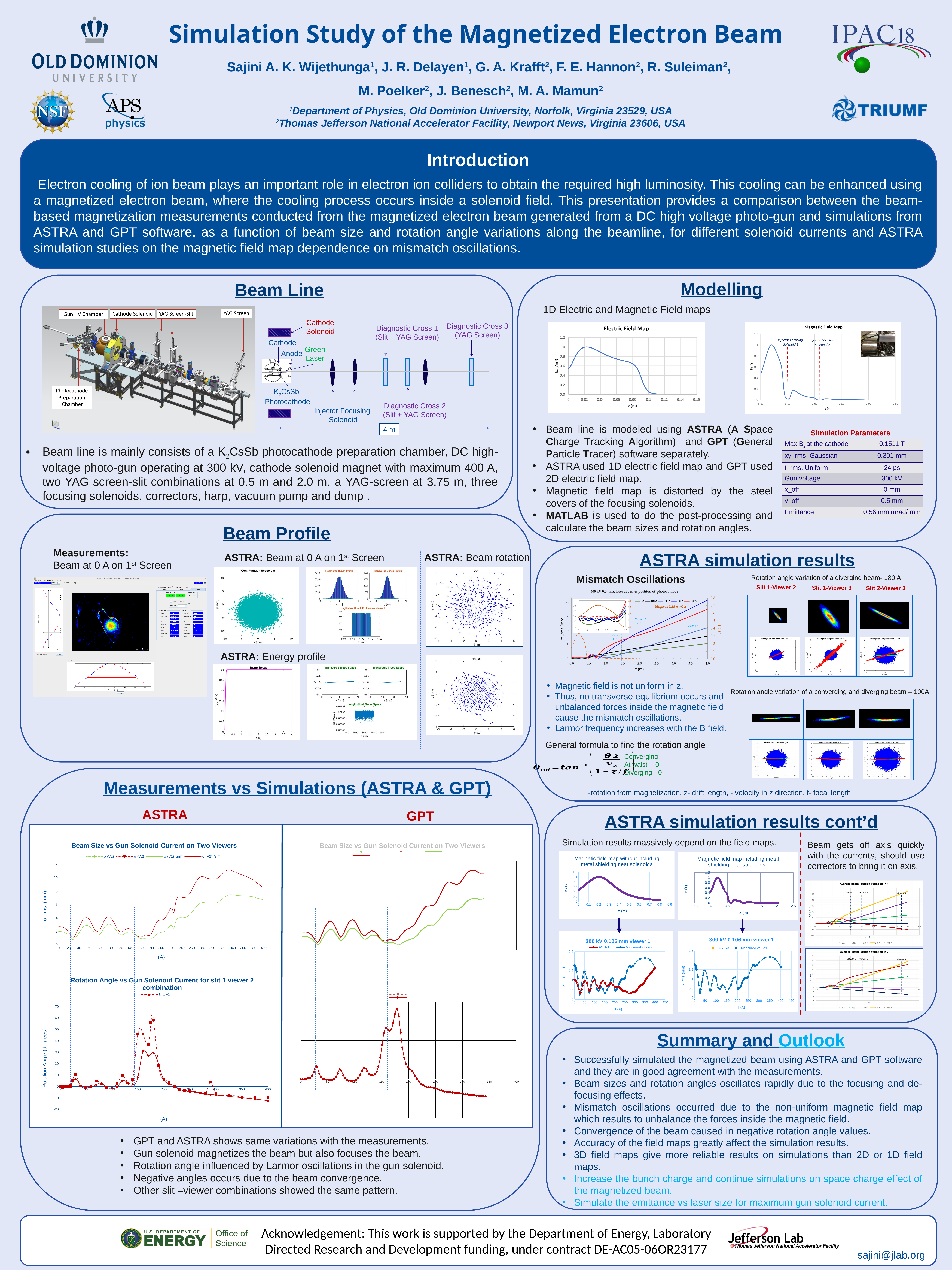
In the 'Magnetic Field Map' chart in the Modelling section, is the peak value greater or less than 0.8? greater What kind of chart is the ASTRA 'Beam Size vs Gun Solenoid Current on Two Viewers' chart in the Measurements vs Simulations section? line chart How many series does the legend of the 'Rotation Angle vs Gun Solenoid Current for slit 1 viewer 2 combination' chart list? 1 In the ASTRA 'Beam Size vs Gun Solenoid Current on Two Viewers' chart, do the beam size values overall rise or fall as the current increases from 0 to 400 A? rise What kind of chart is the 'Electric Field Map' chart in the Modelling section? line chart In the 'Rotation Angle vs Gun Solenoid Current for slit 1 viewer 2 combination' chart, is the rotation angle at 400 A greater or less than 0? less How many series does the legend of the '300 kV 0.106 mm viewer 1' chart in the ASTRA simulation results cont'd section list? 2 How many series does the legend of the ASTRA 'Beam Size vs Gun Solenoid Current on Two Viewers' chart list? 4 In the 'Electric Field Map' chart in the Modelling section, is the peak value greater or less than 0.8? greater What is the x-axis label of the ASTRA 'Beam Size vs Gun Solenoid Current on Two Viewers' chart? I (A)